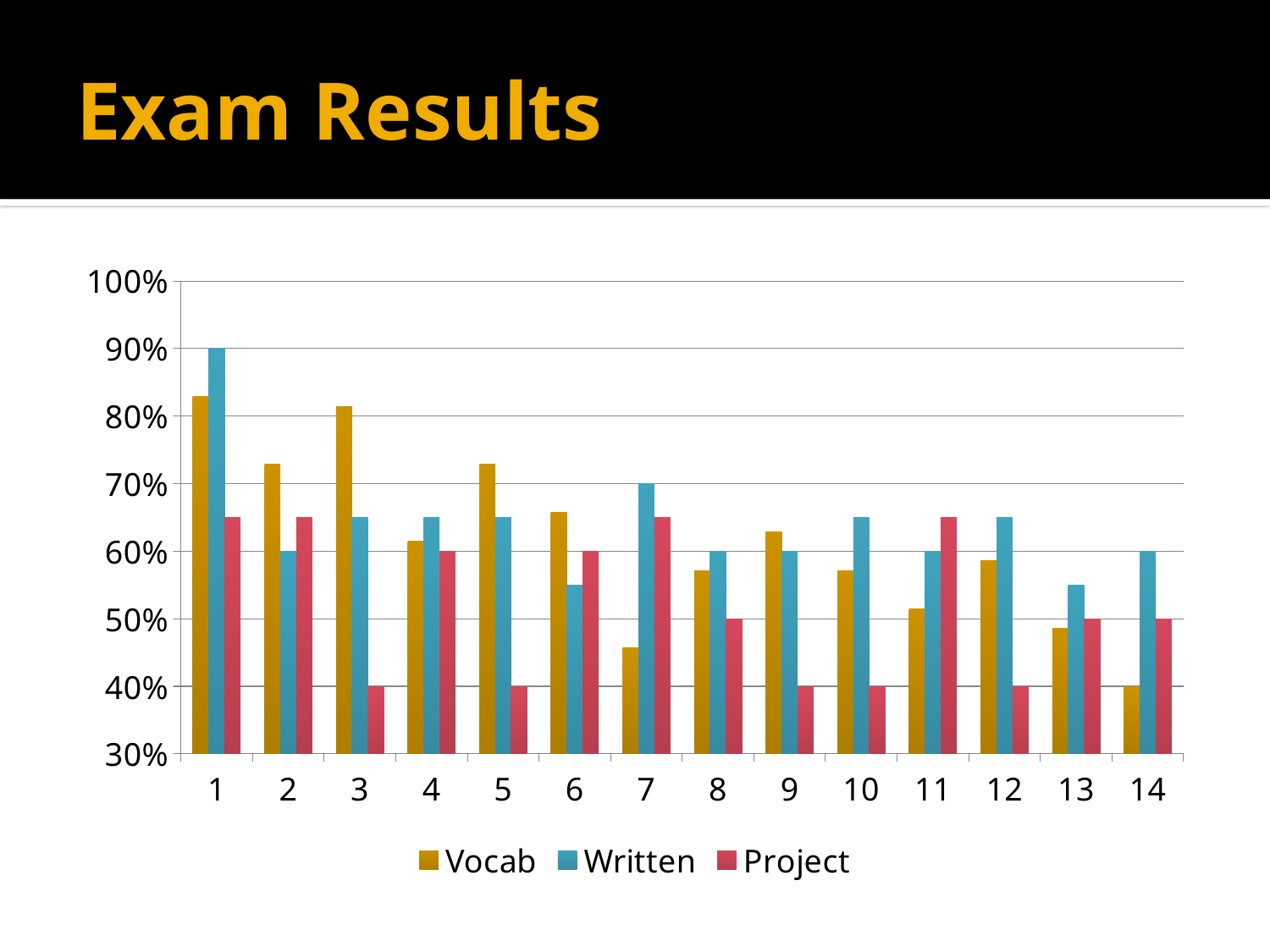
How many series does the legend list? 3 What is the Written value for category 7? 70% Is the Vocab value for category 1 greater or less than 80%? greater For category 3, which is larger, Vocab or Written? Vocab What is the Vocab value for category 14? 40% What is the Written value for category 1? 90% What is the difference between the Written value for category 1 and the Written value for category 14? 30% Which category has the lowest Vocab value? 14 What is the Project value for category 3? 40% Which category has the highest Written value? 1 What type of chart is shown on the slide? Bar chart How many categories are shown along the x axis? 14